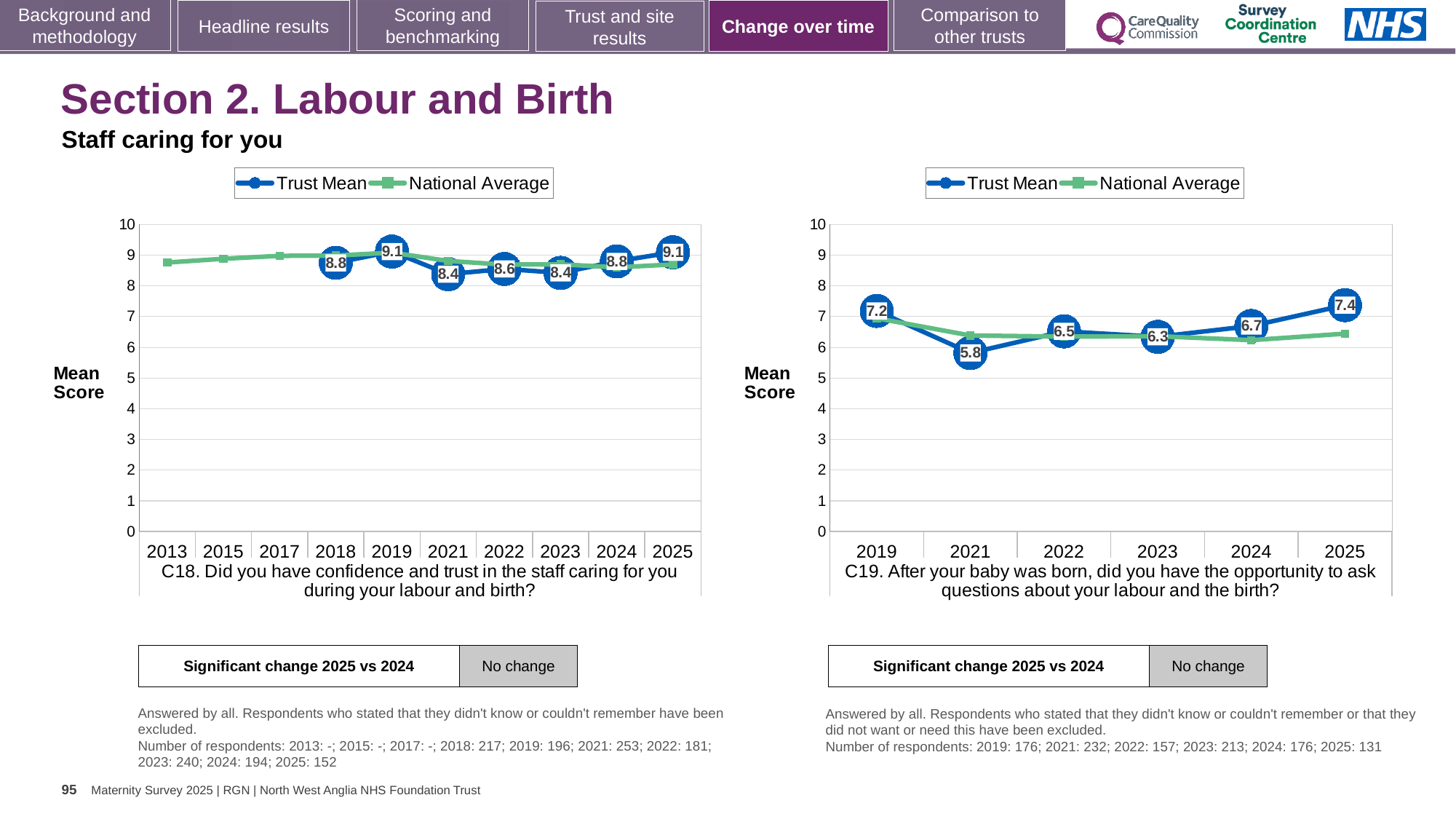
In the C19 chart on the right, which year has the highest Trust Mean? 2025 How many series does the legend of the C18 chart on the left list? 2 In the C19 chart on the right, what is the difference between the Trust Mean for 2025 and 2021? 1.6 In the C19 chart on the right, which year has the lowest Trust Mean? 2021 What type of chart is the C19 chart on the right? Line chart In the C18 chart on the left, what is the Trust Mean for 2021? 8.4 In the C18 chart on the left, is the National Average for 2013 greater or less than 8? greater In the C19 chart on the right, is the Trust Mean for 2024 higher or lower than for 2023? 2024 is higher In the C18 chart on the left, what is the Trust Mean for 2025? 9.1 In the C19 chart on the right, what is the Trust Mean for 2021? 5.8 How many years are shown on the x axis of the C19 chart on the right? 6 In the C18 chart on the left, what is the difference between the Trust Mean for 2019 and 2021? 0.7